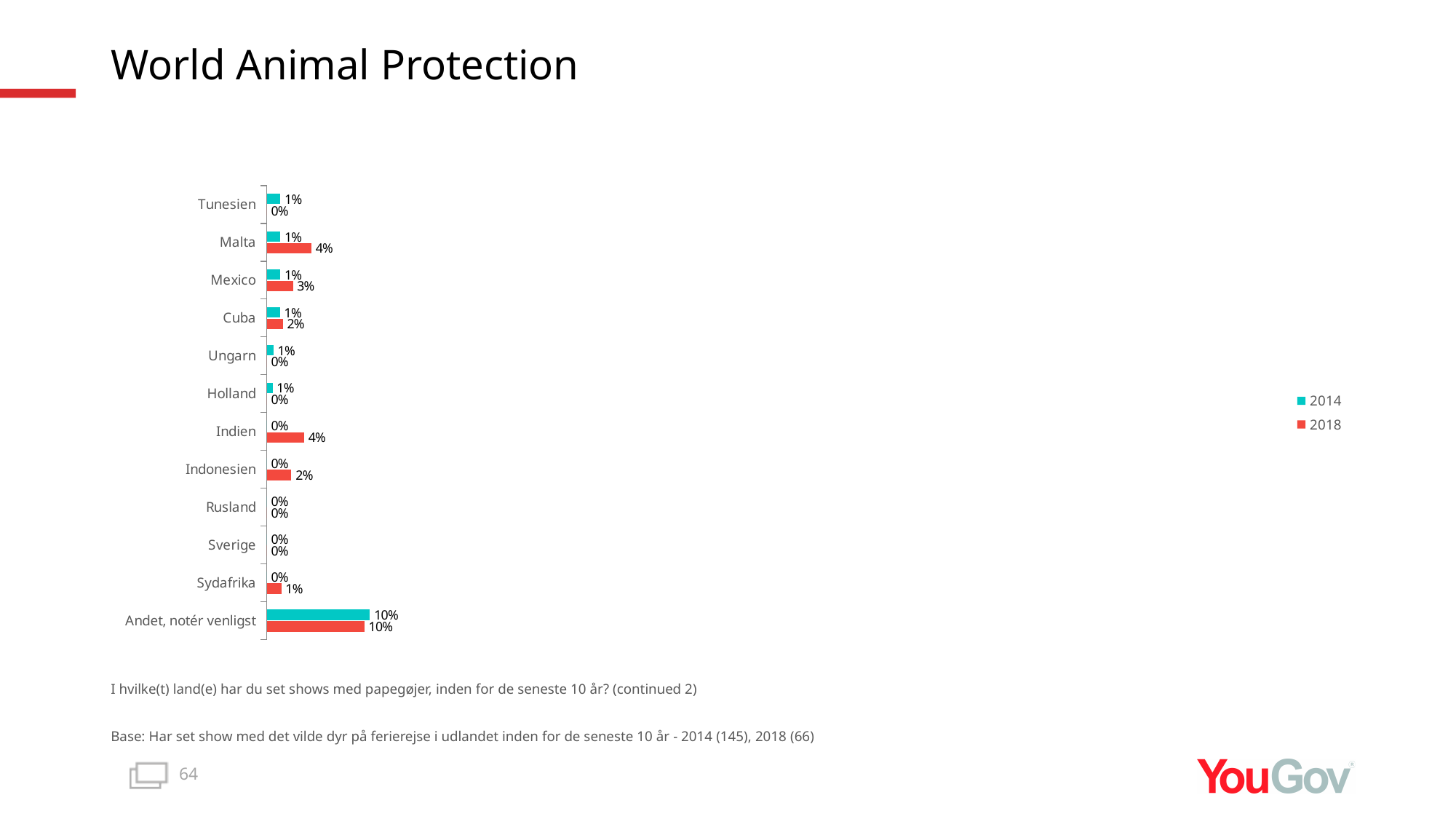
How many categories are shown on the chart? 12 What is the 2018 value for Indonesien? 2% What is the 2014 value for Indien? 0% Which is larger, the 2018 value for Mexico or the 2018 value for Sydafrika? Mexico What kind of chart is shown on the slide? Bar chart Which category has the highest 2018 value? Andet, notér venligst Which series is shown in red in the legend? 2018 What is the difference between the 2014 and 2018 values for Indien? 4% What is the difference between the 2018 values for Malta and Cuba? 2% What is the 2018 value for Malta? 4% What is the 2014 value for Andet, notér venligst? 10% How many series does the legend list? 2